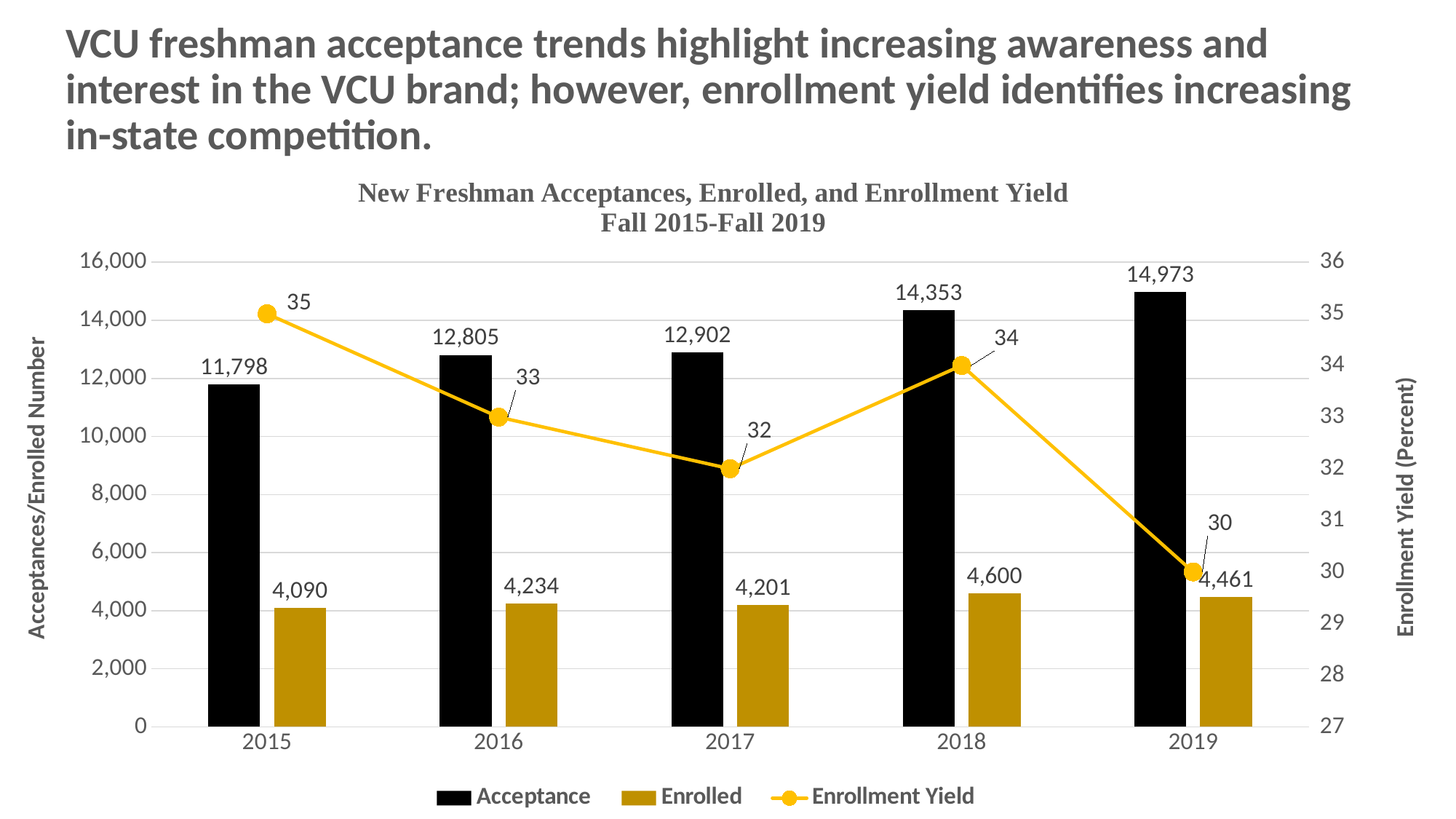
How many years are shown on the x axis? 5 Which year has the lowest Enrollment Yield? 2019 Which is larger, the Enrolled value for 2016 or for 2017? 2016 What is the Acceptance value for 2017? 12,902 Is the Acceptance value for 2018 greater or less than 14,000? greater Does the Acceptance value rise or fall from 2015 to 2019? rise What is the Enrolled value for 2018? 4,600 How many series does the legend list? 3 What is the difference between the Acceptance values for 2019 and 2015? 3,175 Which year has the highest Acceptance value? 2019 What is the Enrollment Yield for 2015? 35 What is the label of the right-hand vertical axis? Enrollment Yield (Percent)